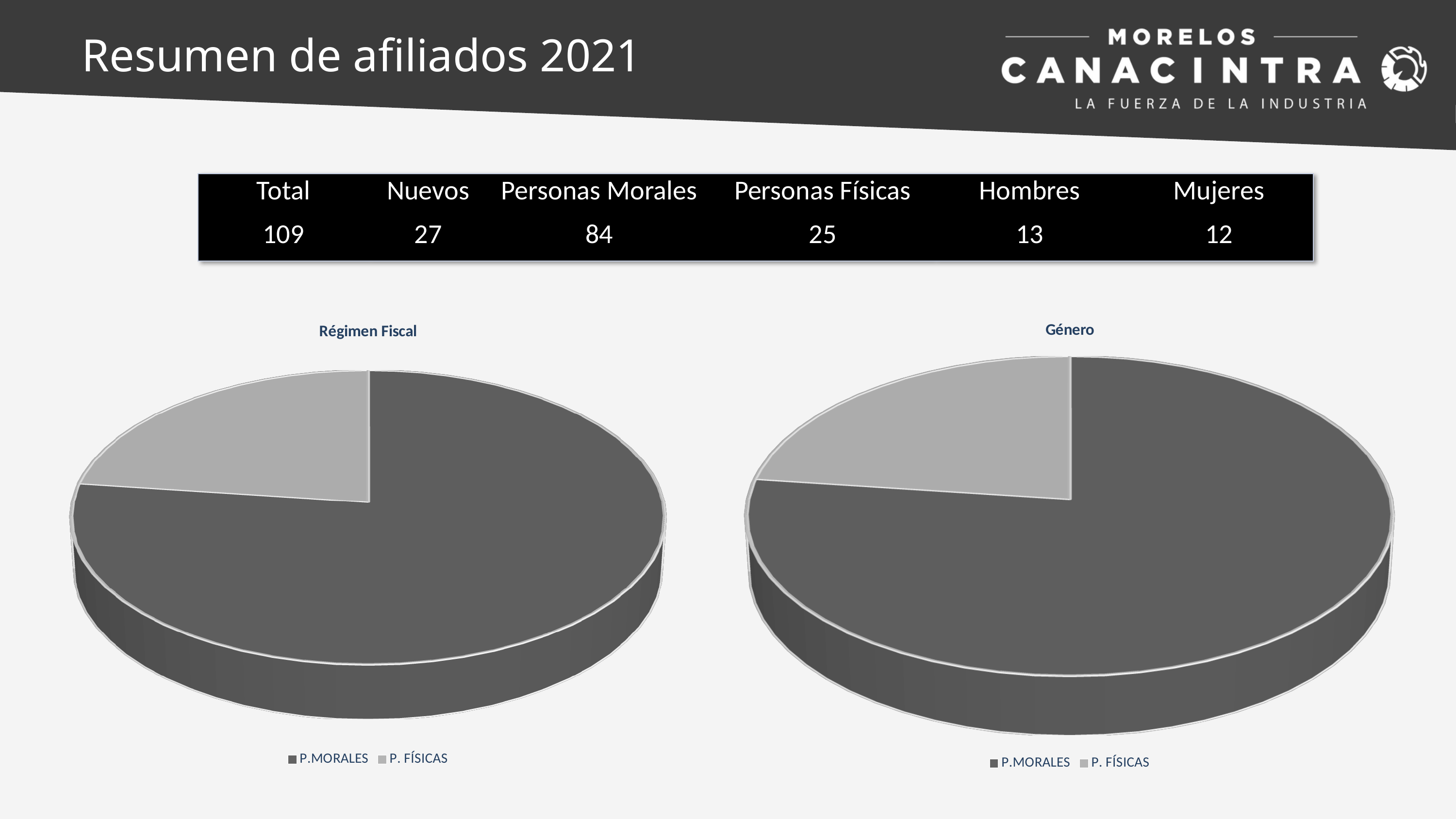
In the "Género" chart, which slice is the smallest? P. FÍSICAS In the "Régimen Fiscal" chart, which slice is larger, P.MORALES or P. FÍSICAS? P.MORALES In the "Género" chart, which slice is larger, P. FÍSICAS or P.MORALES? P.MORALES How many slices does the "Género" pie chart have? 2 How many entries does the legend of the "Régimen Fiscal" chart list? 2 In the "Régimen Fiscal" chart, which slice is the smallest? P. FÍSICAS In the "Régimen Fiscal" chart, which slice is the largest? P.MORALES In the "Régimen Fiscal" chart, which legend entry is shown in the lighter grey colour? P. FÍSICAS What kind of chart is the chart titled "Género"? Pie chart In the "Género" chart, which slice is the largest? P.MORALES What is the title of the pie chart on the left side of the slide? Régimen Fiscal What kind of chart is the chart titled "Régimen Fiscal"? Pie chart